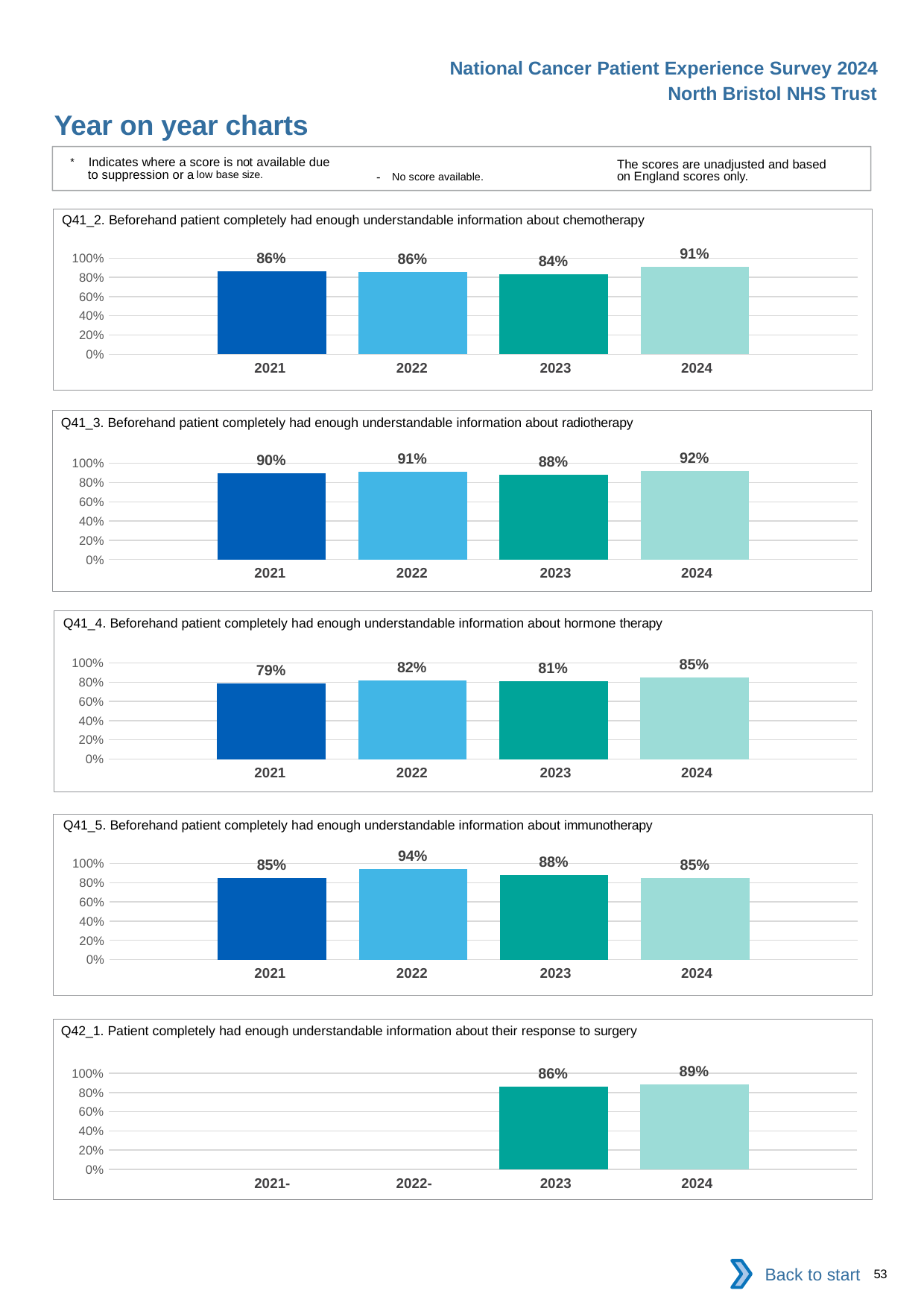
In the Q41_3 chart (radiotherapy), is the value for 2022 larger or smaller than the value for 2021? larger In the Q41_2 chart (chemotherapy), what is the value for 2024? 91% What kind of chart is the Q41_2 chart (chemotherapy)? bar chart In the Q41_5 chart (immunotherapy), what is the difference between the 2022 and 2023 values? 6% In the Q41_4 chart (hormone therapy), what is the difference between the 2024 and 2021 values? 6% How many charts are shown on the slide? 5 In the Q41_5 chart (immunotherapy), which year has the highest value? 2022 In the Q41_2 chart (chemotherapy), which year has the lowest value? 2023 In the Q42_1 chart (response to surgery), how many years have a bar plotted? 2 In the Q41_4 chart (hormone therapy), is the value for 2021 greater or less than 80%? less In the Q42_1 chart (response to surgery), what is the value for 2023? 86% In the Q41_3 chart (radiotherapy), which year has the lowest value? 2023